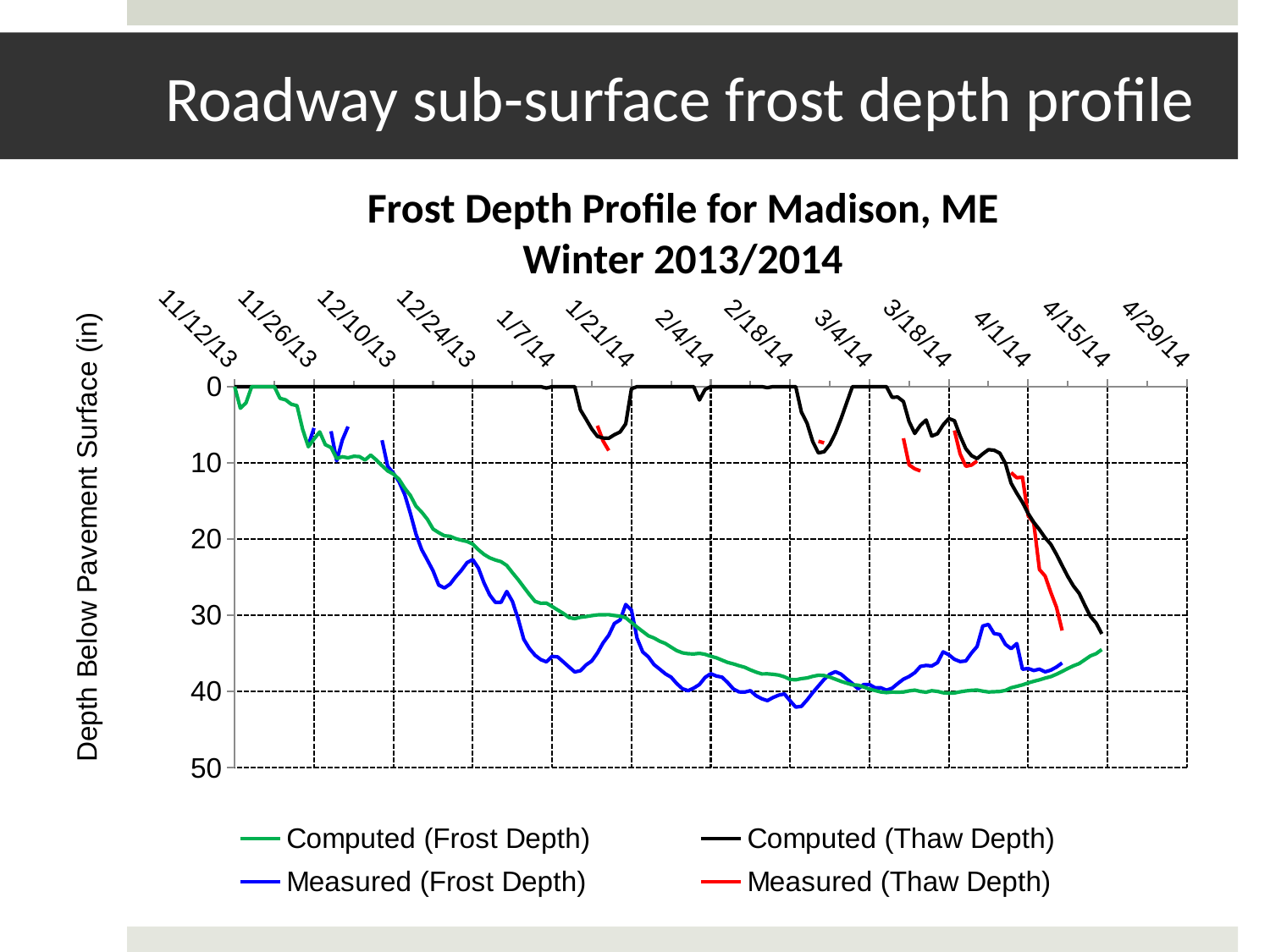
At 12/24/13, which series shows the greater depth, Measured (Frost Depth) or Computed (Frost Depth)? Measured (Frost Depth) What is the title of the chart? Frost Depth Profile for Madison, ME Winter 2013/2014 How many date labels are shown on the x axis? 13 Is the Computed (Frost Depth) value at 2/18/14 greater or less than 30? greater Between 11/12/13 and 2/18/14, does the Computed (Frost Depth) get deeper or shallower? deeper Which colour is used for the Computed (Frost Depth) series? green What kind of chart is shown on the slide? line chart At 1/7/14, which series shows the greater depth, Measured (Frost Depth) or Computed (Frost Depth)? Measured (Frost Depth) How many series does the legend list? 4 Is the Measured (Frost Depth) value at 1/7/14 greater or less than 30? greater